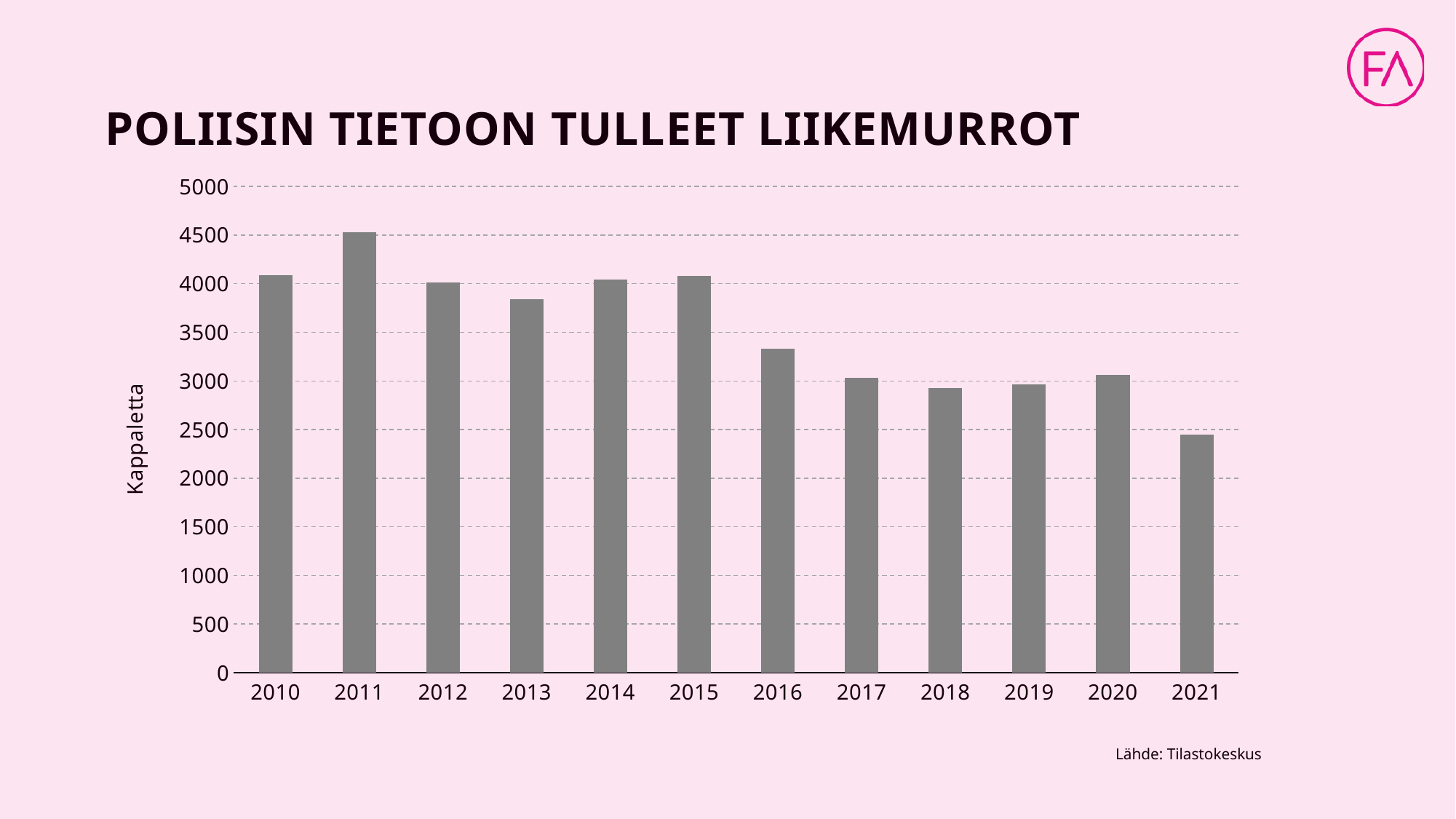
Is the value for 2016 greater or less than 3500? less Which year has a higher value, 2011 or 2012? 2011 What kind of chart is shown on the slide? Bar chart How many years are shown on the x axis of the chart? 12 What is the label on the y axis of the chart? Kappaletta Is the value for 2021 greater or less than 2500? less Which year has a higher value, 2013 or 2014? 2014 Which year has the lowest number of reported business burglaries? 2021 Which year has the highest number of reported business burglaries? 2011 Is the value for 2011 greater or less than 4000? greater Do the values generally rise or fall from 2010 to 2021? Fall